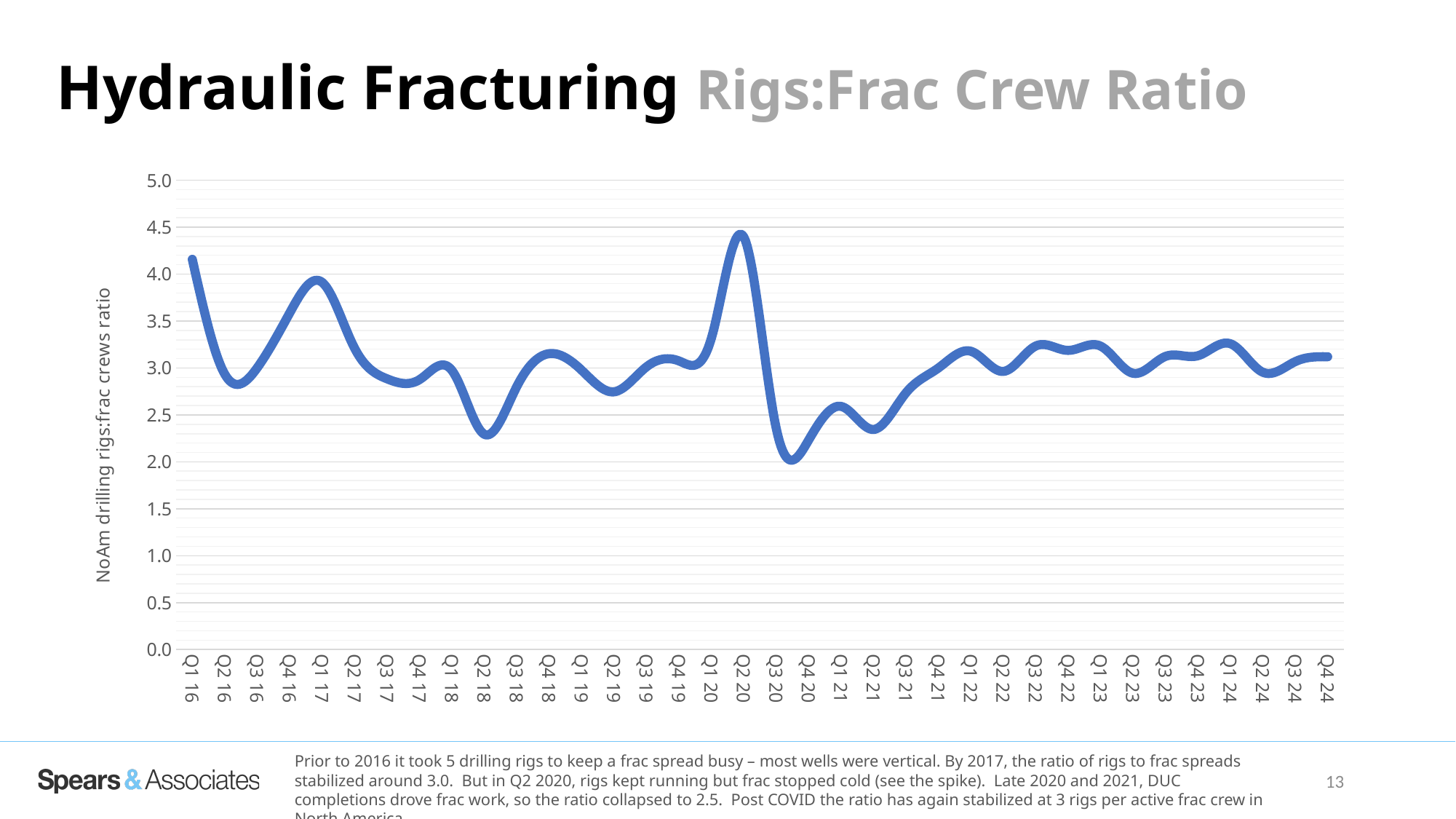
In which quarter does the rigs:frac crews ratio reach its highest value? Q2 20 Which is larger, the value for Q2 18 or the value for Q4 20? Q2 18 Which is larger, the value for Q2 20 or the value for Q1 16? Q2 20 What kind of chart is shown on the slide? Line chart How many quarters are plotted along the x axis? 36 What is the label on the vertical axis? NoAm drilling rigs:frac crews ratio Is the value for Q2 20 greater or less than 4.0? greater Is the value for Q1 17 greater or less than 3.5? greater In which quarter does the rigs:frac crews ratio reach its lowest value? Q4 20 Is the value for Q2 18 greater or less than 2.5? less Does the ratio rise or fall between Q2 20 and Q4 20? Fall